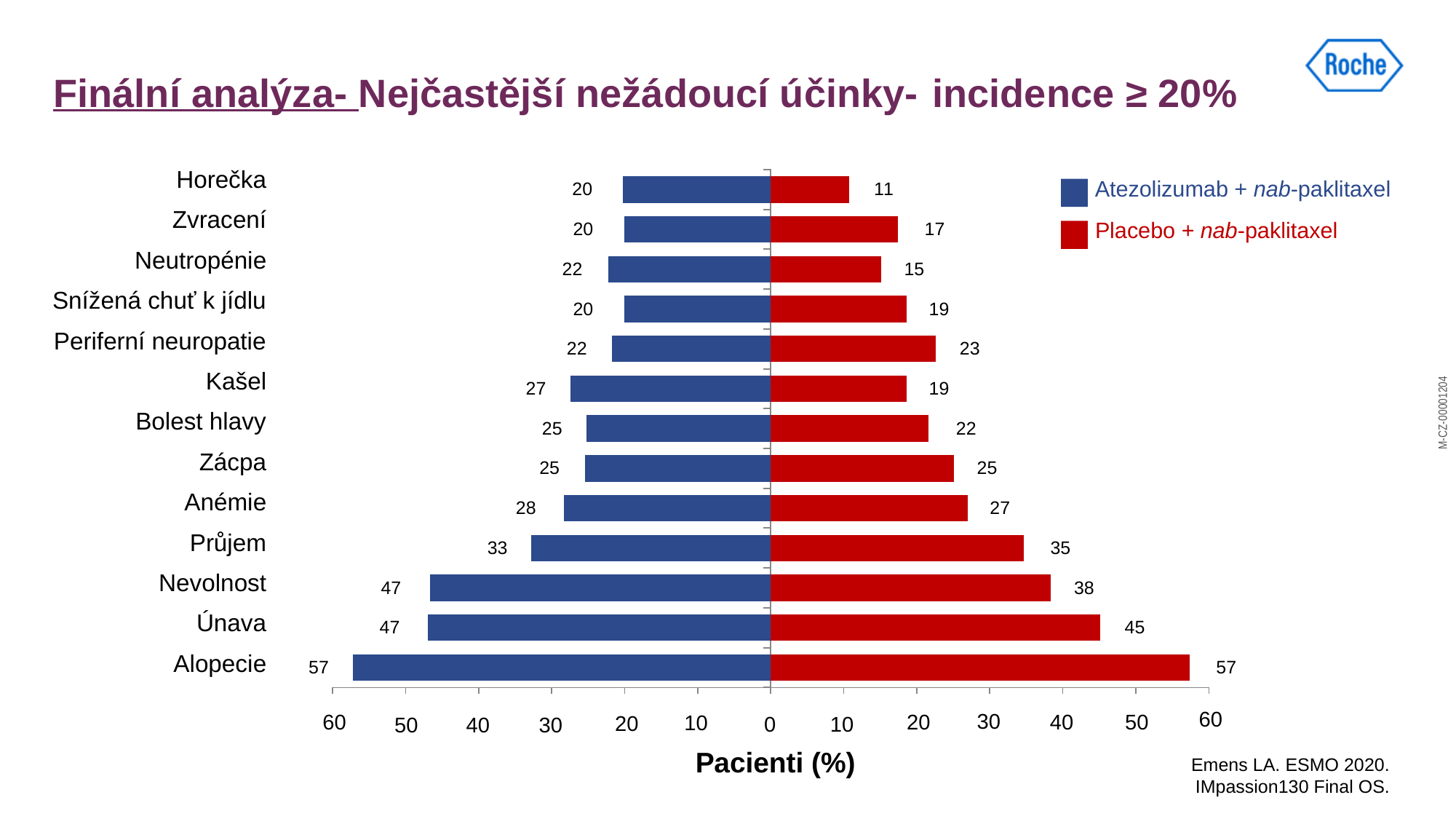
What is the value for Alopecie in the Atezolizumab + nab-paklitaxel series? 57 How many series does the legend list? 2 What is the value for Průjem in the Placebo + nab-paklitaxel series? 35 What is the label of the x axis? Pacienti (%) What is the value for Horečka in the Placebo + nab-paklitaxel series? 11 What is the difference between the Atezolizumab + nab-paklitaxel and Placebo + nab-paklitaxel values for Nevolnost? 9 Which category has the lowest value in the Placebo + nab-paklitaxel series? Horečka For Periferní neuropatie, which series has the larger value: Atezolizumab + nab-paklitaxel or Placebo + nab-paklitaxel? Placebo + nab-paklitaxel Which category has the highest value in the Placebo + nab-paklitaxel series? Alopecie What kind of chart is shown on the slide? Bar chart How many adverse event categories are shown on the chart? 13 Which colour represents the Placebo + nab-paklitaxel series? Red